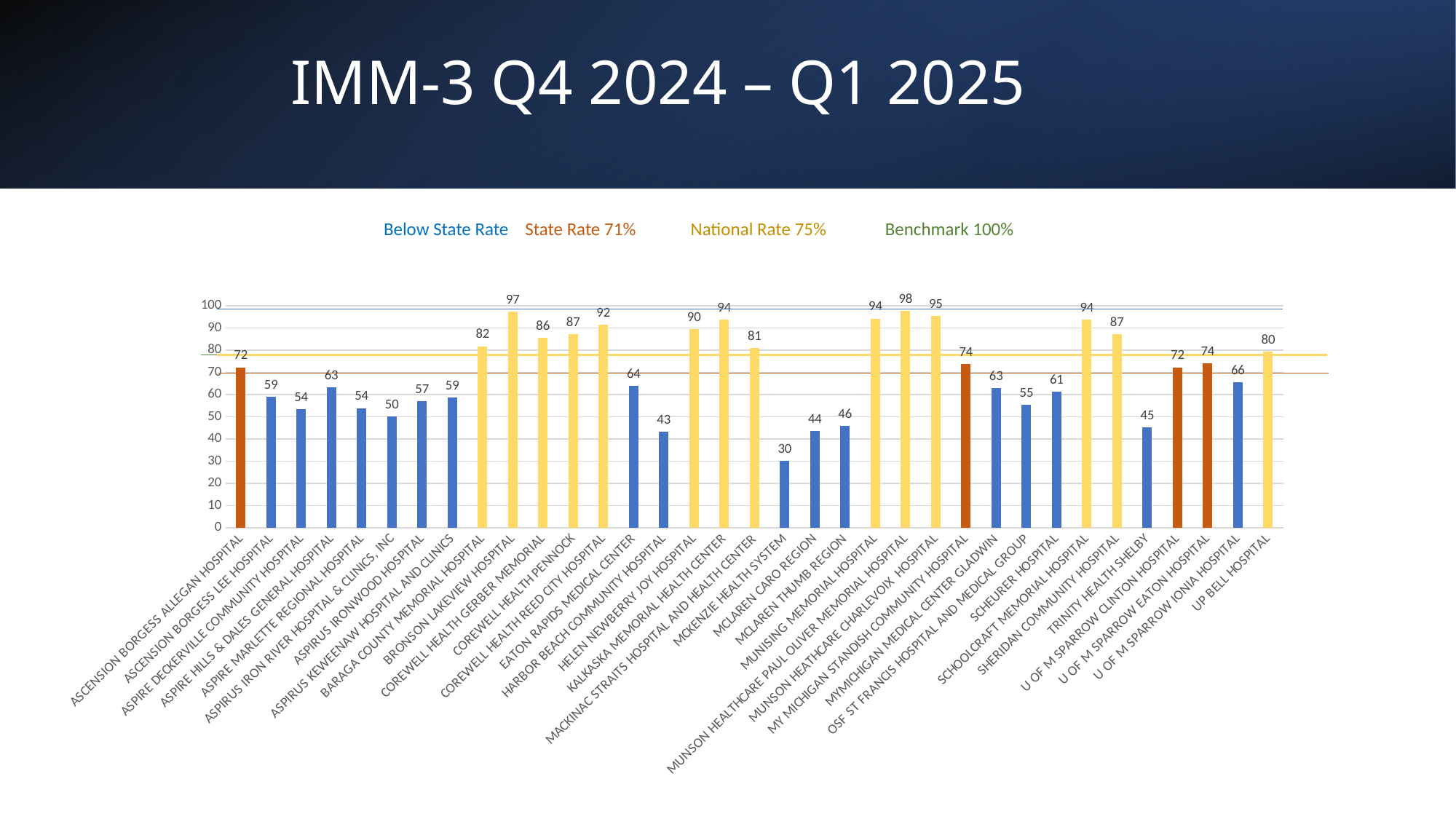
Is the value for HARBOR BEACH COMMUNITY HOSPITAL greater or less than 50? less What is the value for BRONSON LAKEVIEW HOSPITAL? 97 According to the legend, what is the National Rate? 75% What is the difference between the values for COREWELL HEALTH REED CITY HOSPITAL and EATON RAPIDS MEDICAL CENTER? 28 Which is larger, the value for HELEN NEWBERRY JOY HOSPITAL or the value for SHERIDAN COMMUNITY HOSPITAL? HELEN NEWBERRY JOY HOSPITAL According to the legend, what is the State Rate? 71% What is the value for UP BELL HOSPITAL? 80 Which hospital has the lowest value on the chart? MCKENZIE HEALTH SYSTEM What kind of chart is shown on the slide? bar chart How many hospitals are shown on the chart? 35 What is the value for MCKENZIE HEALTH SYSTEM? 30 Which hospital has the highest value on the chart? MUNSON HEALTHCARE PAUL OLIVER MEMORIAL HOSPITAL